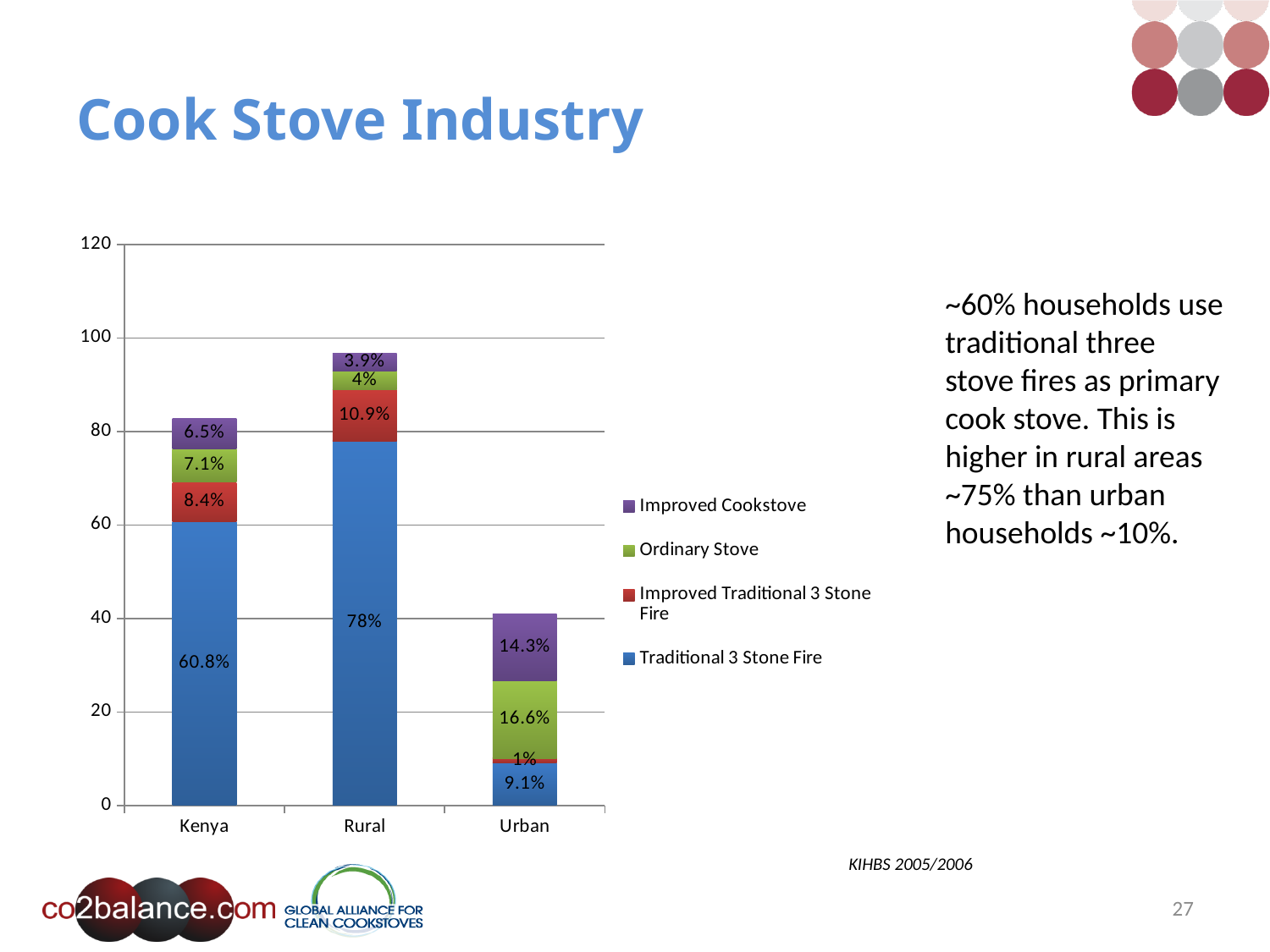
What is the value for Improved Cookstove in the Kenya category? 6.5% Is the total height of the Urban stacked bar greater or less than 60? less How many series does the legend list? 4 What is the difference between the Traditional 3 Stone Fire values for Rural and Urban? 68.9% What is the value for Ordinary Stove in the Urban category? 16.6% Which category has the lowest value for Improved Traditional 3 Stone Fire? Urban What colour represents Traditional 3 Stone Fire in the legend? Blue How many categories are shown on the x axis? 3 What kind of chart is shown on the slide? Stacked bar chart Which category has the highest value for Traditional 3 Stone Fire? Rural What is the value for Traditional 3 Stone Fire in the Rural category? 78% Which is larger, the Ordinary Stove value for Urban or for Kenya? Urban